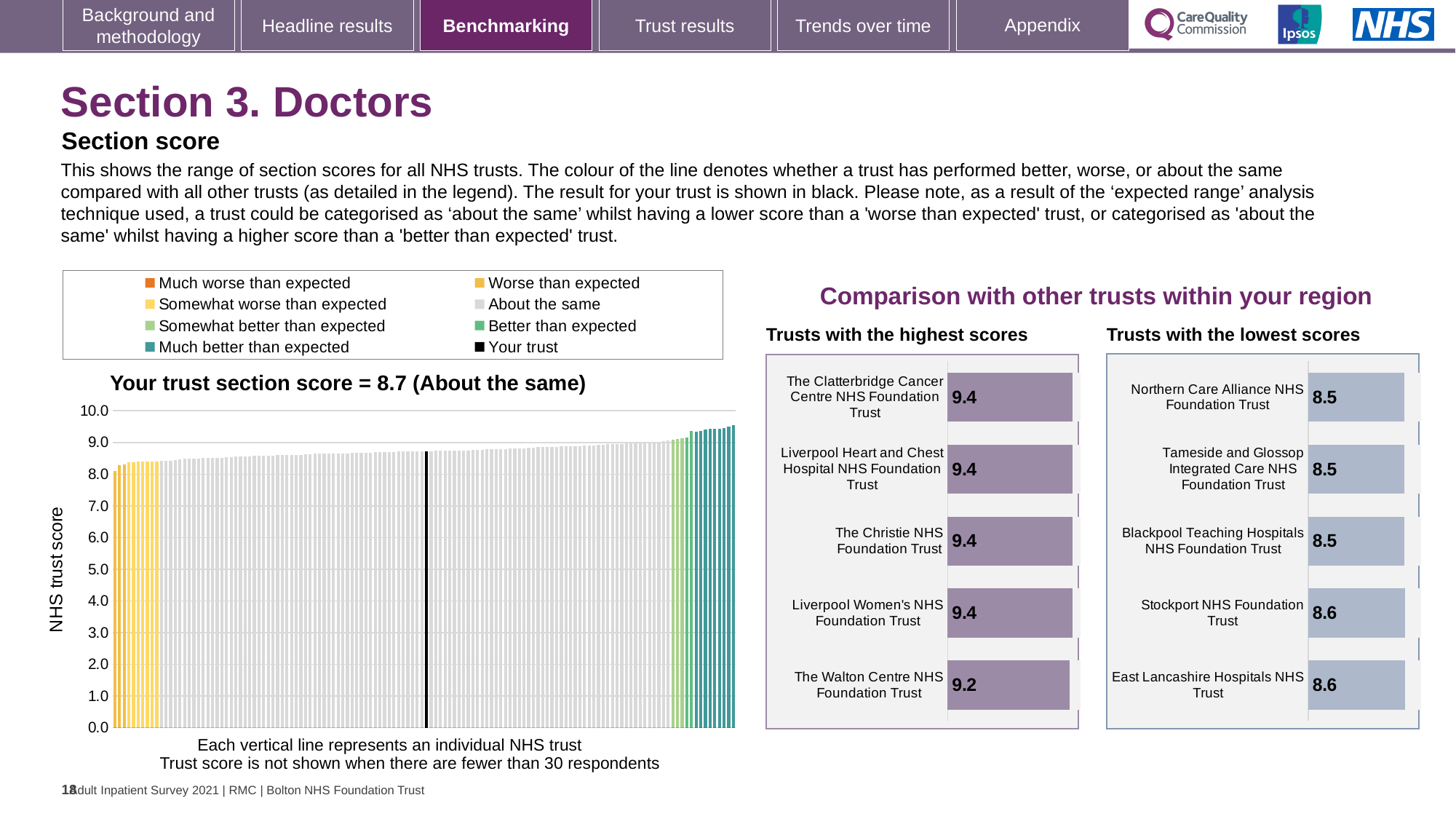
In the 'Trusts with the lowest scores' chart, what is the score for Stockport NHS Foundation Trust? 8.6 How many trusts are shown in the 'Trusts with the lowest scores' chart? 5 In the 'Trusts with the highest scores' chart, what is the score for The Walton Centre NHS Foundation Trust? 9.2 How many entries does the legend above the main chart list? 8 In the 'Trusts with the lowest scores' chart, which has the larger score: Northern Care Alliance NHS Foundation Trust or East Lancashire Hospitals NHS Trust? East Lancashire Hospitals NHS Trust In the main chart, do the trust scores rise or fall from left to right along the x axis? rise What kind of chart is the main chart showing the range of section scores for all NHS trusts? bar chart In the 'Trusts with the highest scores' chart, which trust has the lowest score? The Walton Centre NHS Foundation Trust In the main chart, is the value for your trust (the black line) greater or less than 8.0? greater In the main chart 'Your trust section score', which category does your trust fall into according to the title? About the same In the main chart 'Your trust section score', what is the section score for your trust? 8.7 In the 'Trusts with the highest scores' chart, what is the difference between the score for The Christie NHS Foundation Trust and The Walton Centre NHS Foundation Trust? 0.2